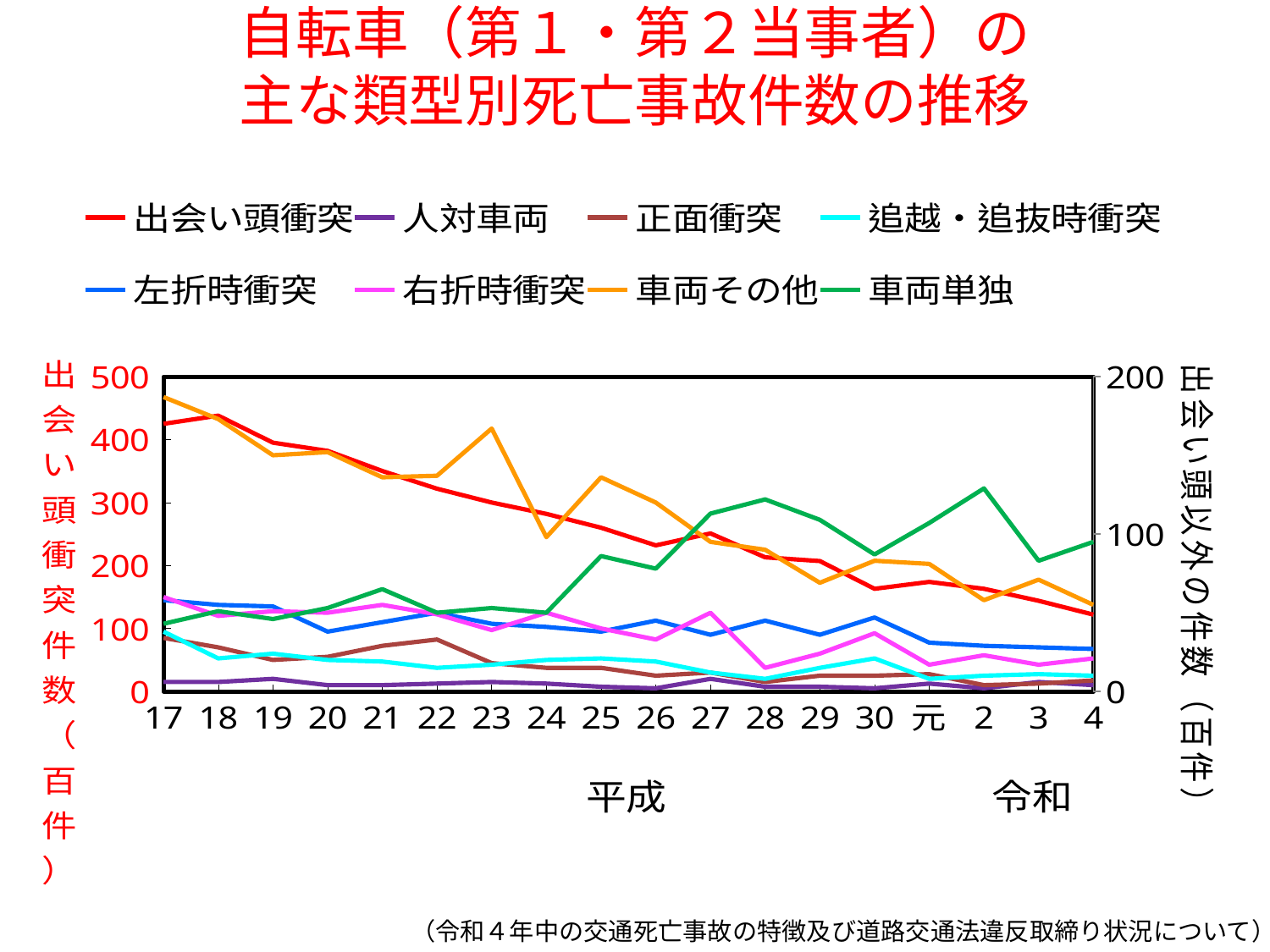
Does the 出会い頭衝突 line generally rise or fall from 平成17 to 令和4? fall What kind of chart is shown on the slide? line chart Does the 車両単独 line rise or fall between 平成24 and 平成28? rise How many years (points) are shown along the x axis? 18 In 令和2, which is larger: 車両単独 or 車両その他? 車両単独 How many series does the legend list? 8 Which series has the lowest value in 平成26? 人対車両 Is the value for 左折時衝突 in 平成17 (right axis) greater or less than 100? less Is the value for 車両その他 in 平成17 (right axis) greater or less than 150? greater What is the title of the right-hand vertical axis? 出会い頭以外の件数（百件） Is the value for 出会い頭衝突 in 令和4 (left axis) greater or less than 200? less